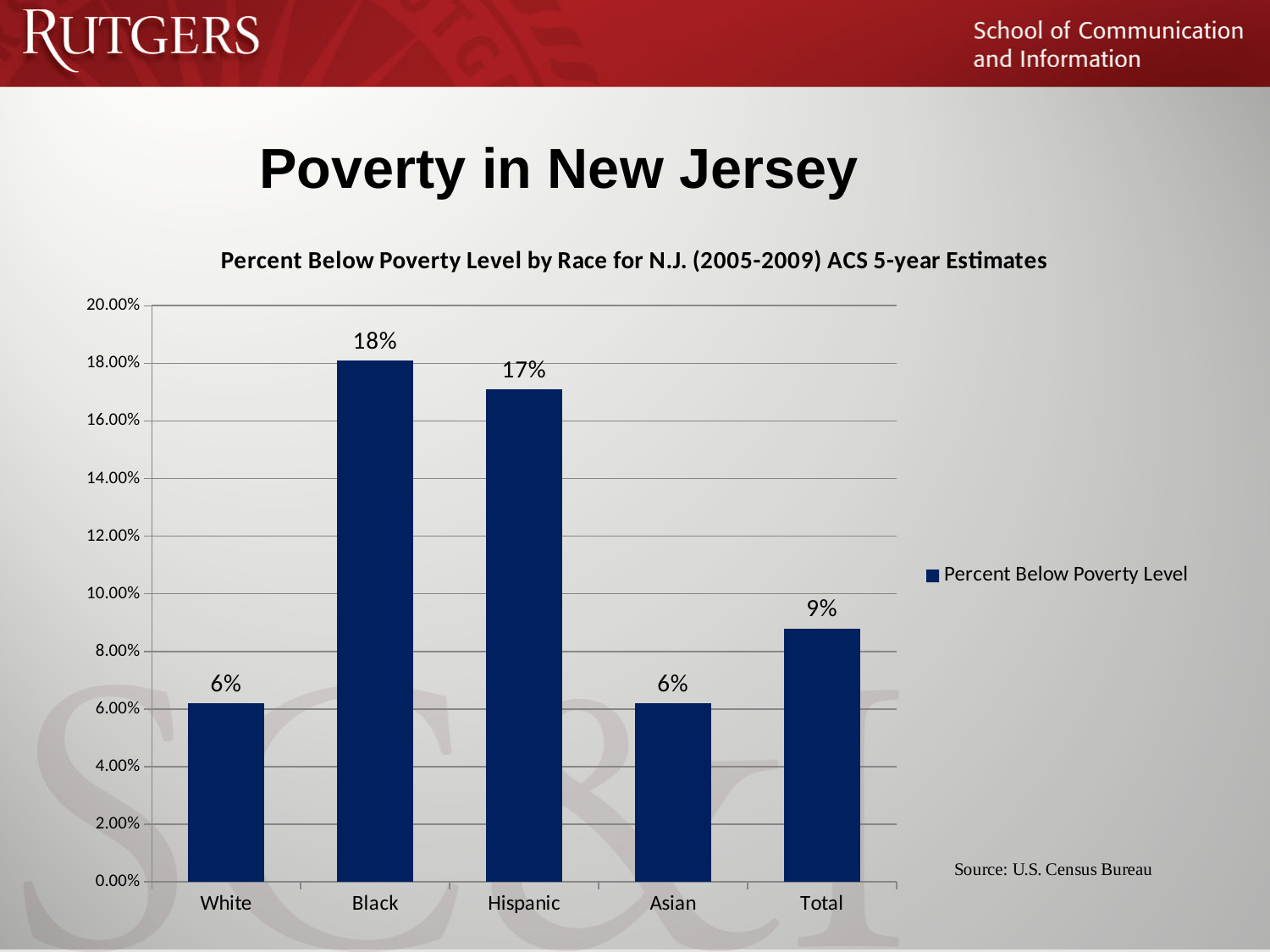
Which category has the highest percent below poverty level? Black How many categories are shown on the x axis? 5 Is the value for Total greater or less than 10.00%? less What is the percent below poverty level for Black residents? 18% What is the difference between the percent below poverty level for Black and White residents? 12% What is the percent below poverty level for Asian residents? 6% Which is larger, the percent below poverty level for Black residents or for Hispanic residents? Black What kind of chart is shown on the slide? bar chart What is the percent below poverty level for Hispanic residents? 17% What is the difference between the Total percent below poverty level and the value for Asian residents? 3% What series name does the legend list? Percent Below Poverty Level What is the percent below poverty level shown for the Total category? 9%